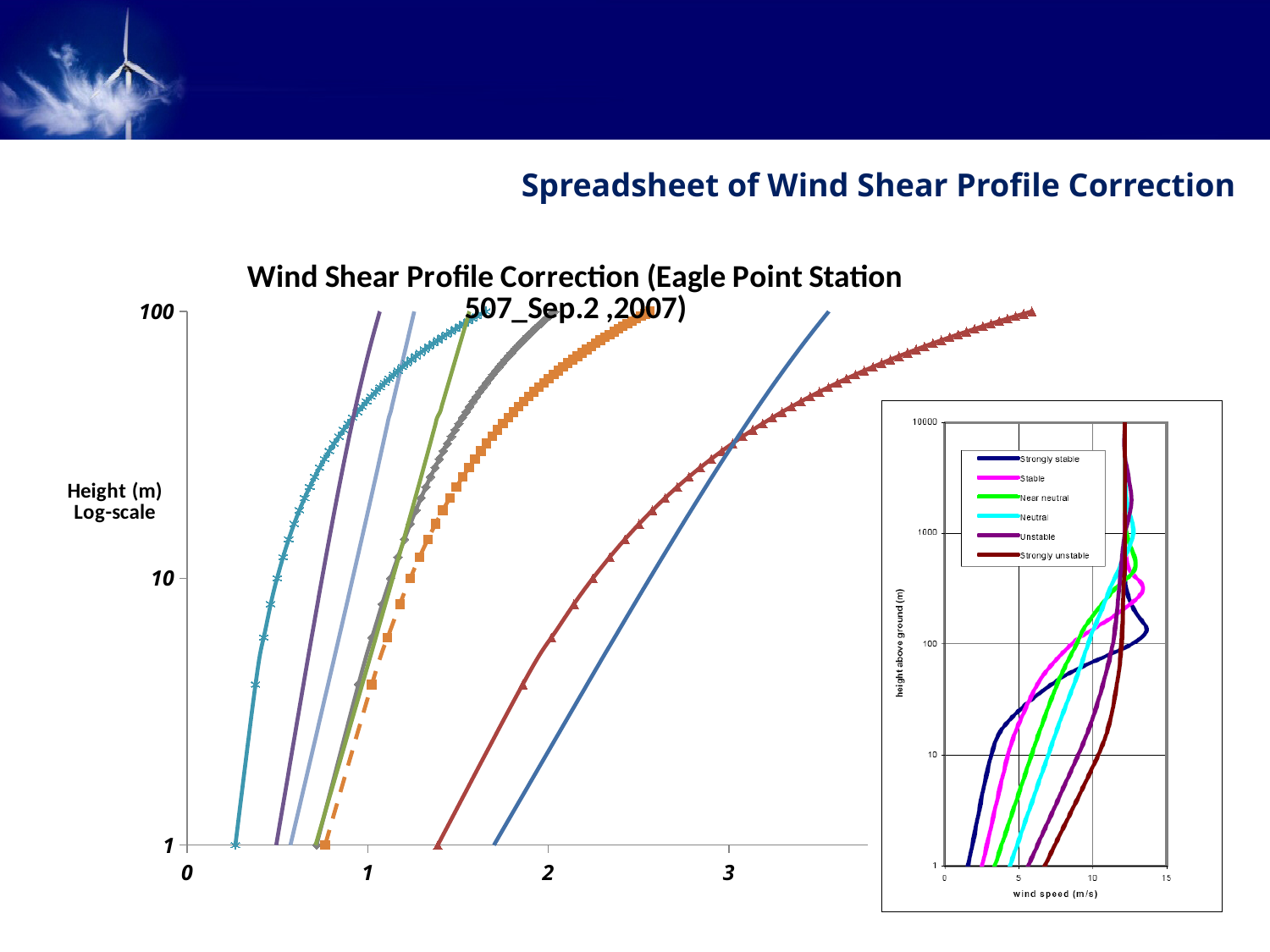
In the small inset chart on the right, what is the x-axis label? wind speed (m/s) What kind of chart is the large chart titled "Wind Shear Profile Correction (Eagle Point Station 507_Sep.2 ,2007)"? Line chart What is the y-axis label of the large chart titled "Wind Shear Profile Correction (Eagle Point Station 507_Sep.2 ,2007)"? Height (m) Log-scale In the small inset chart on the right, is the wind speed of the "Strongly stable" series at a height of 100 m greater or less than 10? greater What is the highest tick value shown on the y-axis of the large chart titled "Wind Shear Profile Correction (Eagle Point Station 507_Sep.2 ,2007)"? 100 In the small inset chart on the right, is the wind speed of the "Strongly stable" series at a height of 10 m greater or less than 5? less In the small inset chart on the right, which series is listed first in the legend? Strongly stable How many series does the legend of the small inset chart on the right list? 6 What kind of chart is the small inset chart on the right of the slide? Line chart In the small inset chart on the right, what is the highest tick value shown on the y-axis? 10000 What is the highest tick value shown on the x-axis of the large chart titled "Wind Shear Profile Correction (Eagle Point Station 507_Sep.2 ,2007)"? 3